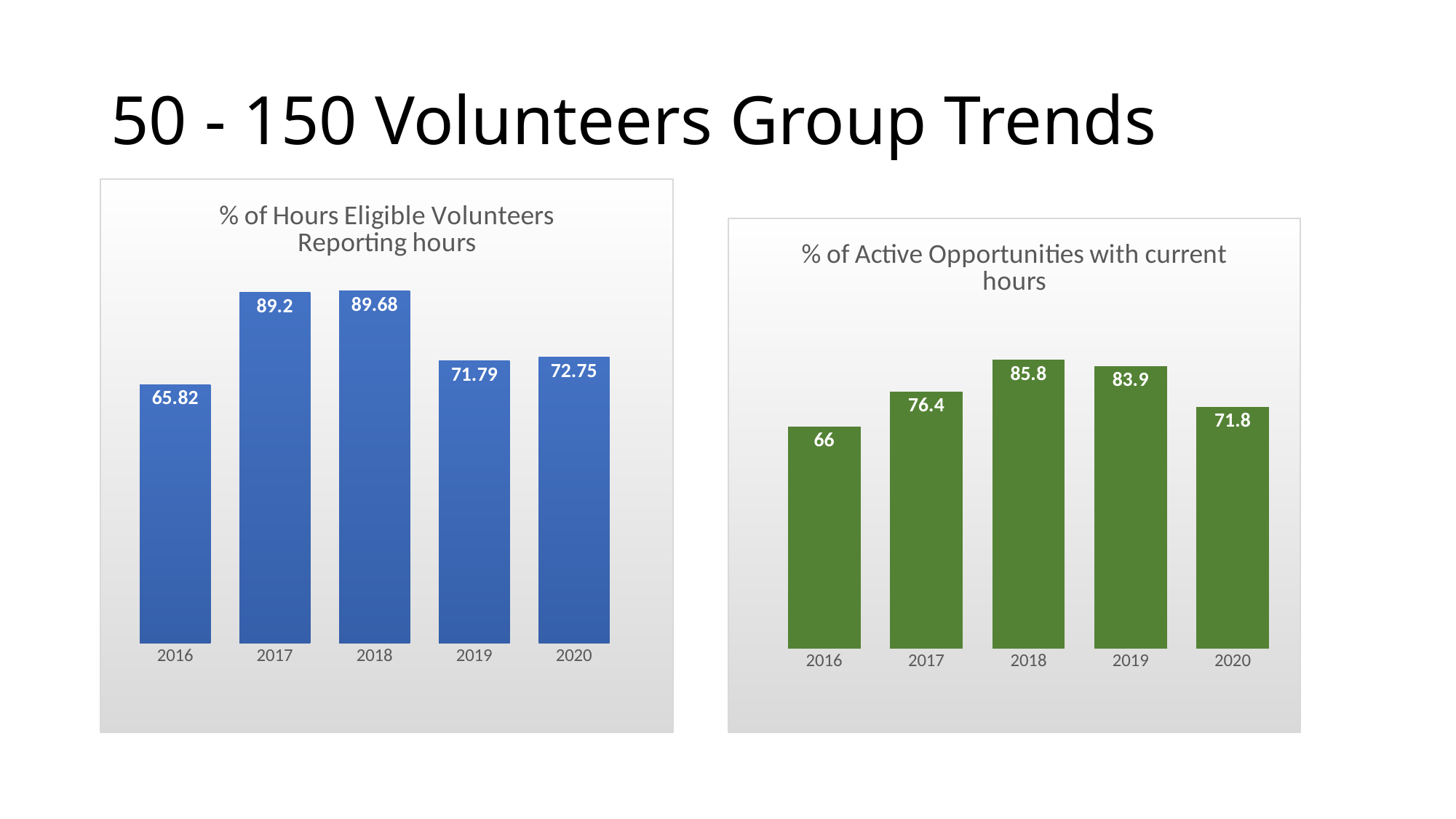
How many years are shown in the '% of Active Opportunities with current hours' chart? 5 In the '% of Hours Eligible Volunteers Reporting hours' chart, which is larger, the value for 2017 or the value for 2020? 2017 In the '% of Active Opportunities with current hours' chart, which year has the highest value? 2018 In the '% of Hours Eligible Volunteers Reporting hours' chart, what is the value for 2016? 65.82 In the '% of Active Opportunities with current hours' chart, what is the value for 2020? 71.8 What type of chart is the '% of Hours Eligible Volunteers Reporting hours' chart? Bar chart In the '% of Hours Eligible Volunteers Reporting hours' chart, what is the difference between the 2018 and 2016 values? 23.86 In the '% of Active Opportunities with current hours' chart, what is the difference between the 2018 and 2020 values? 14 In the '% of Active Opportunities with current hours' chart, what is the value for 2017? 76.4 In the '% of Hours Eligible Volunteers Reporting hours' chart, what is the value for 2019? 71.79 In the '% of Hours Eligible Volunteers Reporting hours' chart, which year has the highest value? 2018 In the '% of Active Opportunities with current hours' chart, which year has the lowest value? 2016